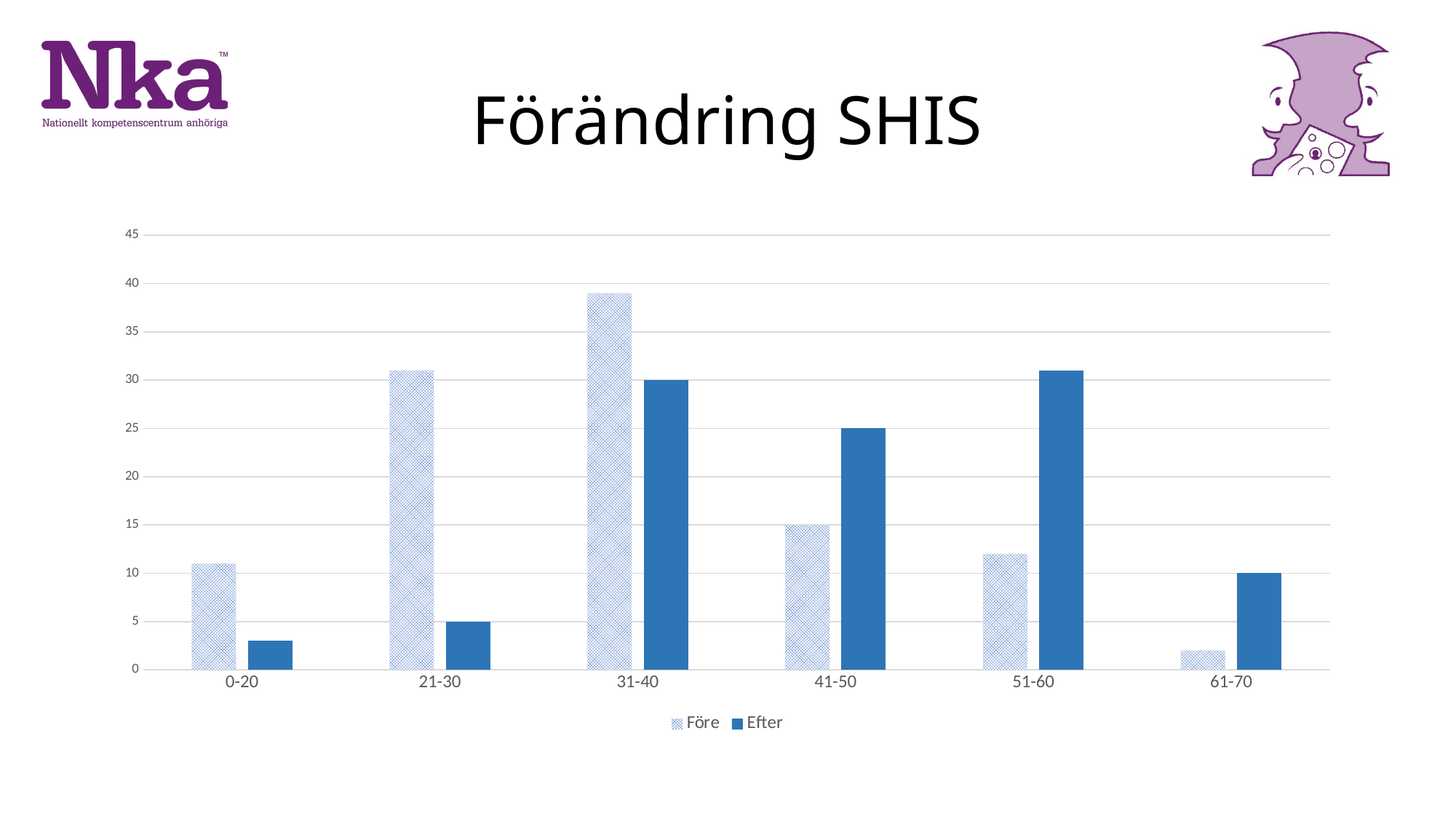
What is the title of the chart on the slide? Förändring SHIS What is the Efter value for the 41-50 category? 25 What is the Efter value for the 31-40 category? 30 How many series does the legend list? 2 How many categories are shown on the x axis? 6 What is the Före value for the 41-50 category? 15 What is the Efter value for the 61-70 category? 10 Which is larger for the 51-60 category, Före or Efter? Efter Which category has the highest Före value? 31-40 Is the Före value for 21-30 greater or less than 30? greater What kind of chart is shown on the slide? bar chart Which category has the lowest Efter value? 0-20